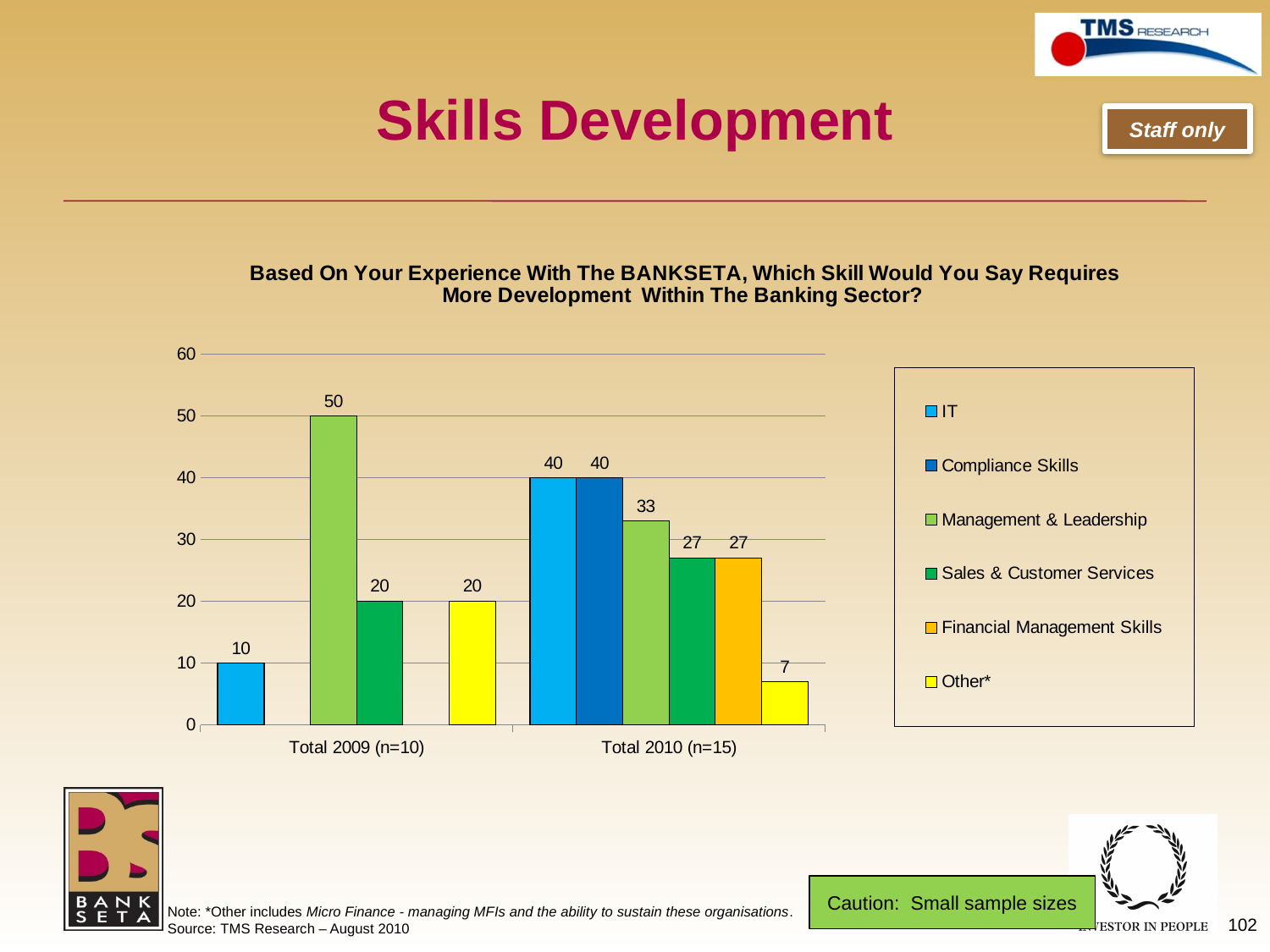
What is the value for Management & Leadership in Total 2009 (n=10)? 50 How many series does the legend list? 6 Which is larger in Total 2010 (n=15): Management & Leadership or Sales & Customer Services? Management & Leadership What colour represents Financial Management Skills in the legend? Orange What is the value for Sales & Customer Services in Total 2009 (n=10)? 20 Which skill has the lowest value in Total 2010 (n=15)? Other* What is the value for IT in Total 2010 (n=15)? 40 What is the value for Other* in Total 2010 (n=15)? 7 What kind of chart is shown on the slide? Bar chart How many categories are shown on the x axis? 2 Which skill has the highest value in Total 2009 (n=10)? Management & Leadership What is the difference between the IT values for Total 2010 (n=15) and Total 2009 (n=10)? 30